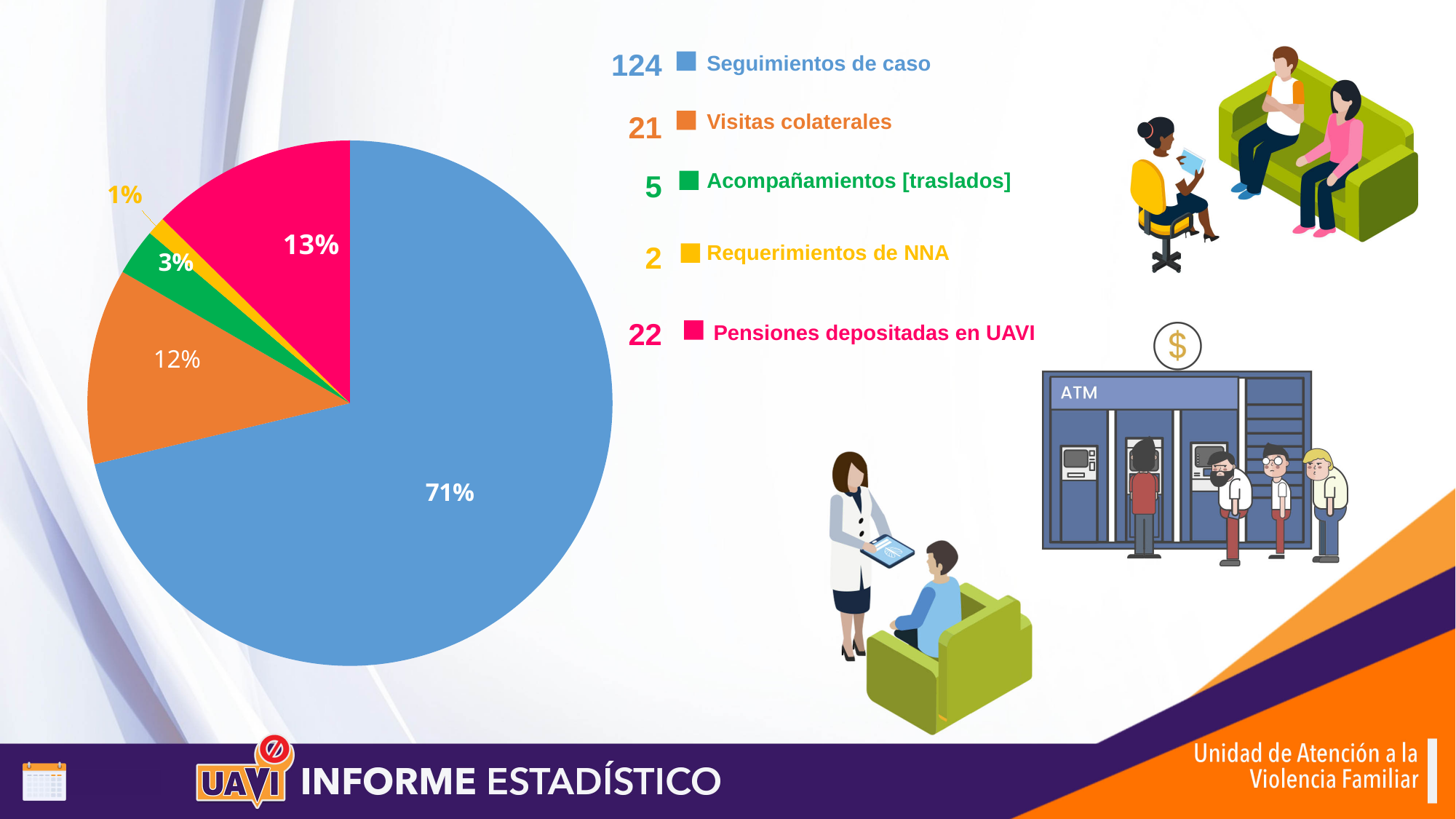
What is the difference in percentage points between Pensiones depositadas en UAVI and Visitas colaterales? 1% What percentage of the pie chart corresponds to Visitas colaterales? 12% Which is larger, the slice for Visitas colaterales or the slice for Acompañamientos [traslados]? Visitas colaterales Which category has the largest slice of the pie chart? Seguimientos de caso Which category has the smallest slice of the pie chart? Requerimientos de NNA How many categories does the pie chart show? 5 What count is listed next to Seguimientos de caso in the legend? 124 What percentage of the pie chart corresponds to Seguimientos de caso? 71% What percentage of the pie chart corresponds to Acompañamientos [traslados]? 3% What kind of chart is shown on the slide? pie chart What percentage of the pie chart corresponds to Pensiones depositadas en UAVI? 13% What percentage of the pie chart corresponds to Requerimientos de NNA? 1%